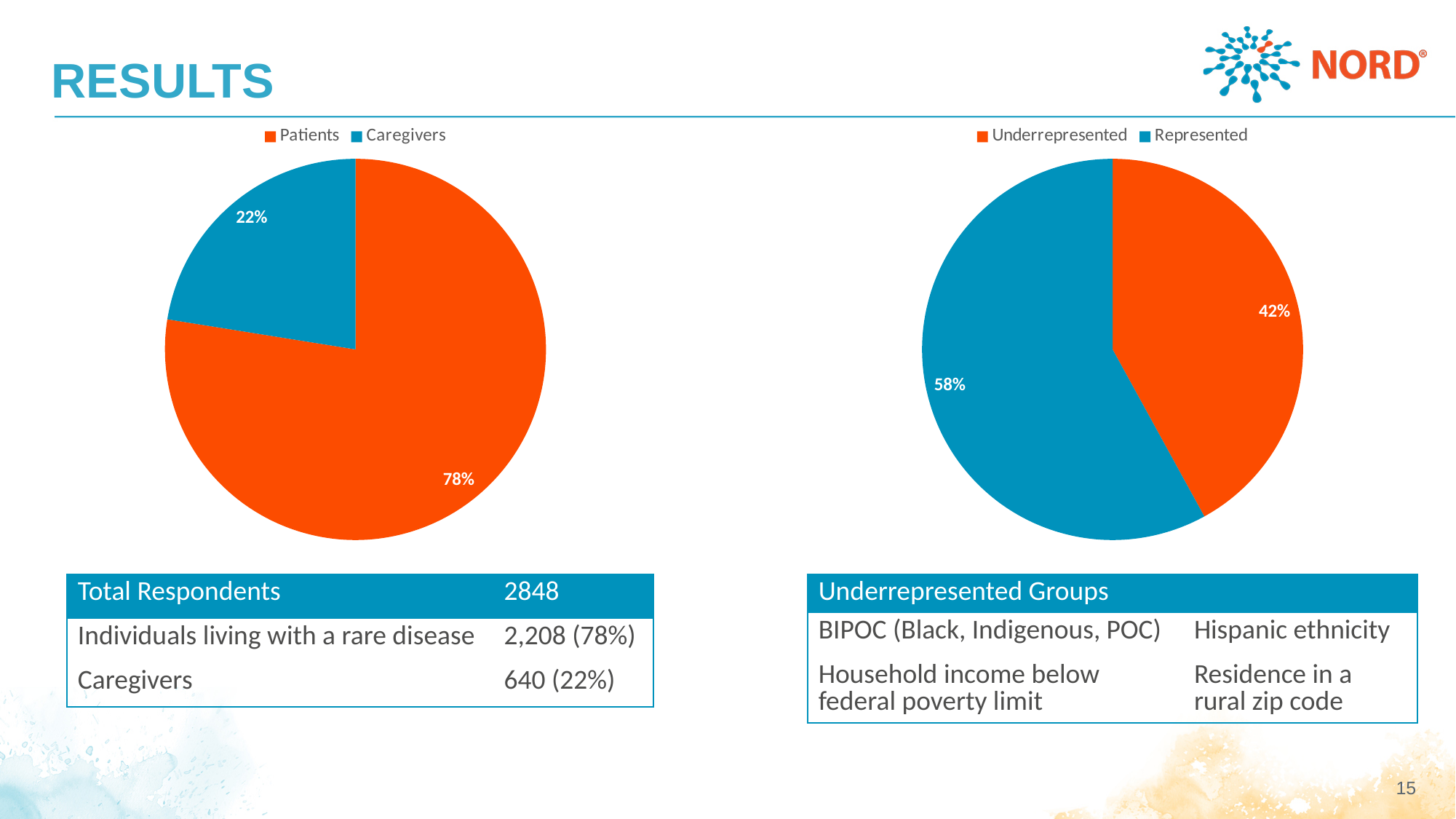
In the left pie chart, what percentage is shown for Caregivers? 22% In the left pie chart, what percentage is shown for Patients? 78% In the left pie chart, what is the difference in percentage points between Patients and Caregivers? 56 What type of chart is the left chart on the slide? Pie chart In the right pie chart, what is the difference in percentage points between Represented and Underrepresented? 16 In the right pie chart, which is larger, Underrepresented or Represented? Represented In the left pie chart, which slice is the largest? Patients In the right pie chart, what percentage is shown for Represented? 58% In the right pie chart, which slice is the smallest? Underrepresented What colour is the Underrepresented slice in the right pie chart? Orange In the right pie chart, what percentage is shown for Underrepresented? 42% How many slices does the right pie chart have? 2